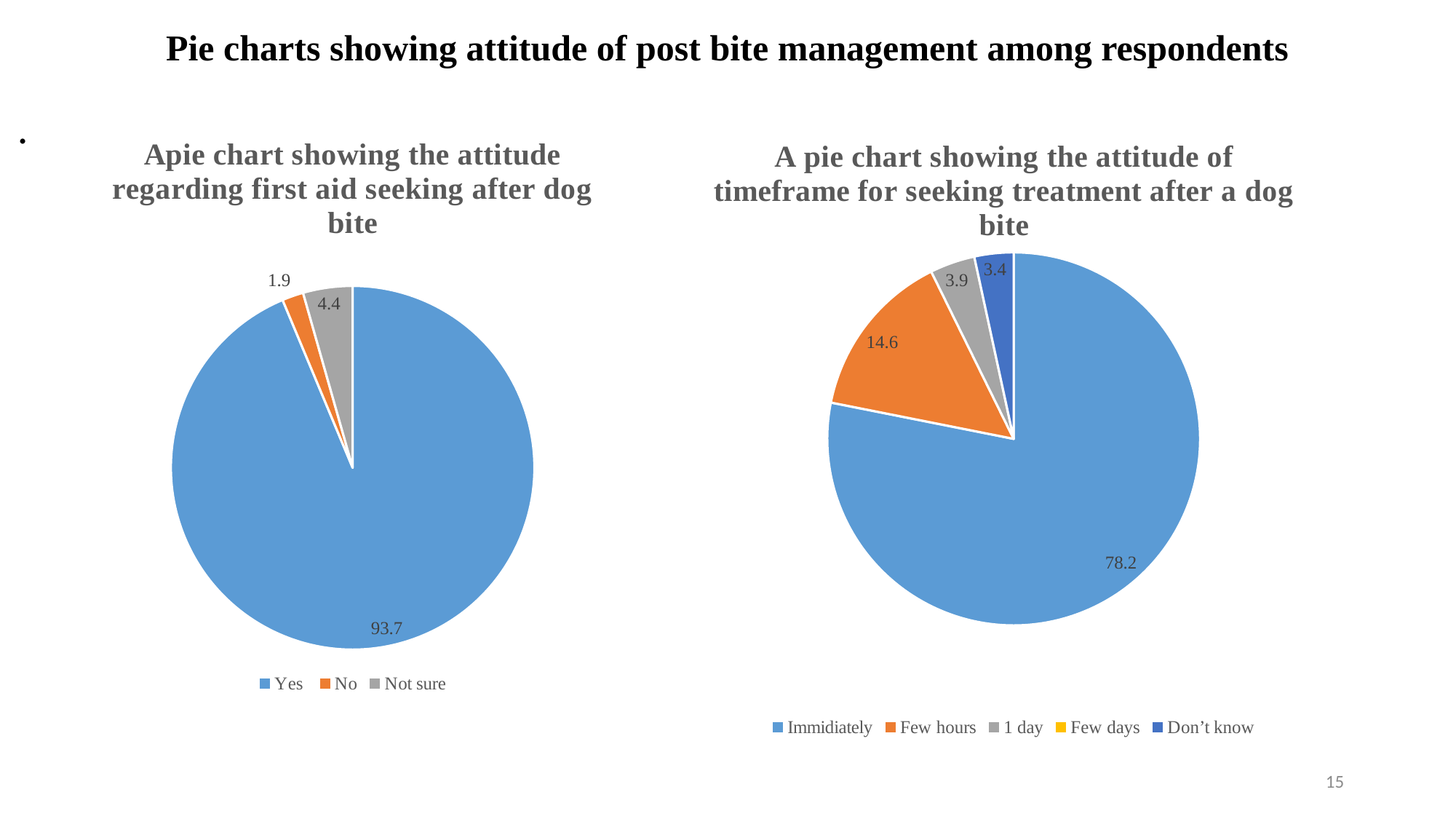
In the right pie chart on timeframe for seeking treatment, what is the value for Immidiately? 78.2 In the left pie chart on first aid seeking after a dog bite, what is the difference between the Not sure and No values? 2.5 In the left pie chart on first aid seeking after a dog bite, what is the value for Yes? 93.7 In the left pie chart on first aid seeking after a dog bite, what is the value for Not sure? 4.4 What type of chart is used on this slide? Pie chart In the left pie chart on first aid seeking after a dog bite, what is the value for No? 1.9 In the left pie chart on first aid seeking after a dog bite, which category has the smallest slice? No How many entries does the legend of the right pie chart on timeframe for seeking treatment list? 5 In the right pie chart on timeframe for seeking treatment, what is the value for Few hours? 14.6 In the right pie chart on timeframe for seeking treatment, what is the value for Don't know? 3.4 In the right pie chart on timeframe for seeking treatment, which is larger, 1 day or Don't know? 1 day How many entries does the legend of the left pie chart on first aid seeking list? 3